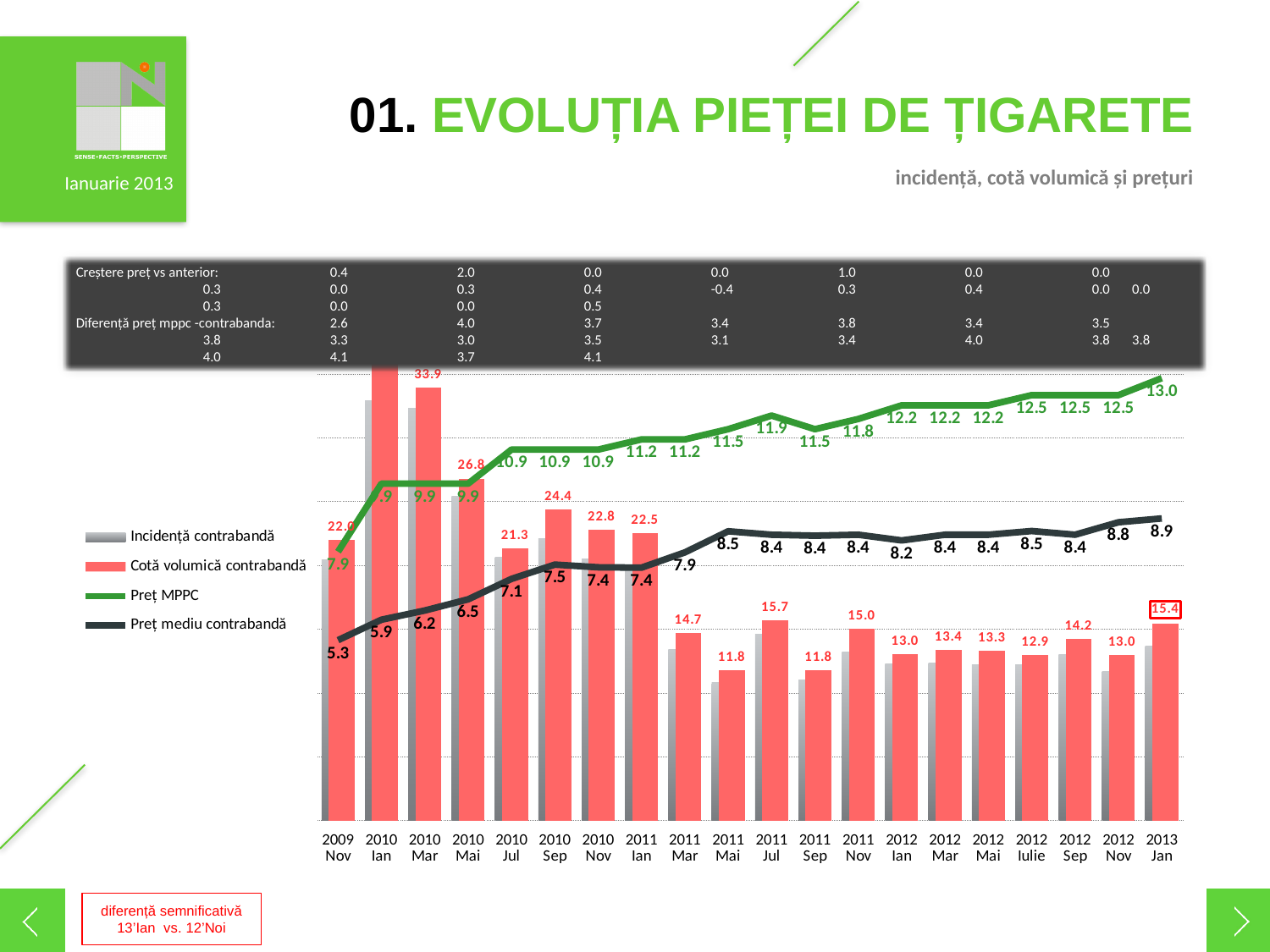
How many time periods are shown on the x axis? 20 Does Preț MPPC generally rise or fall from 2009 Nov to 2013 Jan? rise In which period does Preț MPPC reach its highest value? 2013 Jan What is the value of Cotă volumică contrabandă for 2013 Jan? 15.4 How many series does the legend list? 4 What is the value of Preț mediu contrabandă for 2012 Nov? 8.8 In which period is Preț mediu contrabandă at its lowest? 2009 Nov What is the difference between Cotă volumică contrabandă in 2013 Jan and in 2012 Nov? 2.4 Which is larger, Cotă volumică contrabandă in 2011 Jul or in 2011 Nov? 2011 Jul By how much did Preț MPPC increase from 2009 Nov to 2013 Jan? 5.1 What is the value of Cotă volumică contrabandă for 2011 Jul? 15.7 What is the value of Preț MPPC for 2009 Nov? 7.9